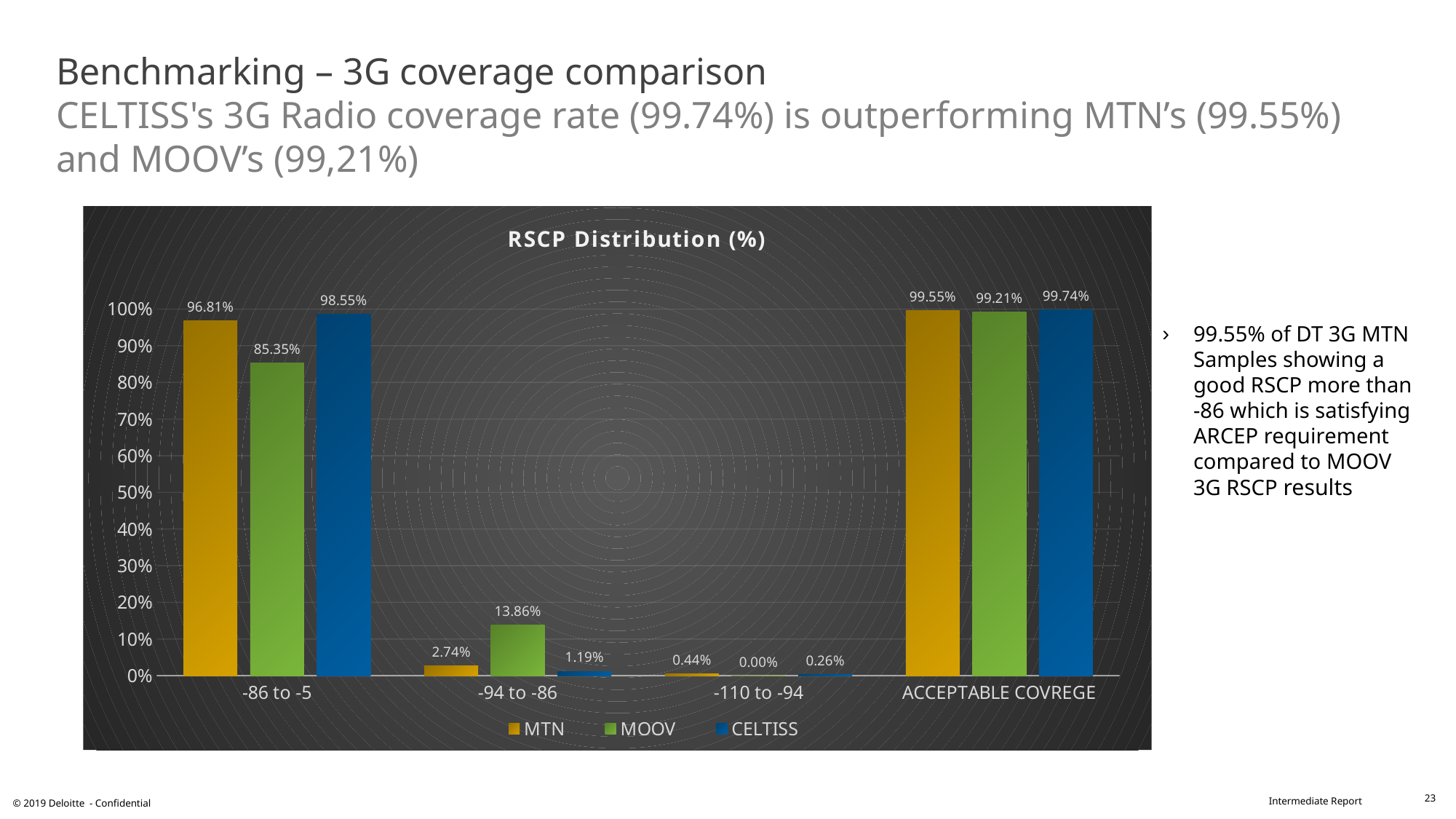
How many categories are shown on the x axis? 4 Which series has the highest value in the -86 to -5 category? CELTISS What is the CELTISS value for ACCEPTABLE COVREGE? 99.74% Which series has the lowest value in the -94 to -86 category? CELTISS What is the difference between the MOOV and MTN values in the -94 to -86 category? 11.12% What is the title of the chart? RSCP Distribution (%) What is the MOOV value for the -94 to -86 category? 13.86% What is the MOOV value for the -110 to -94 category? 0.00% What is the MTN value for the -86 to -5 category? 96.81% How many series does the legend list? 3 What kind of chart is shown on the slide? Bar chart Which is larger in the -86 to -5 category, the MTN value or the MOOV value? MTN